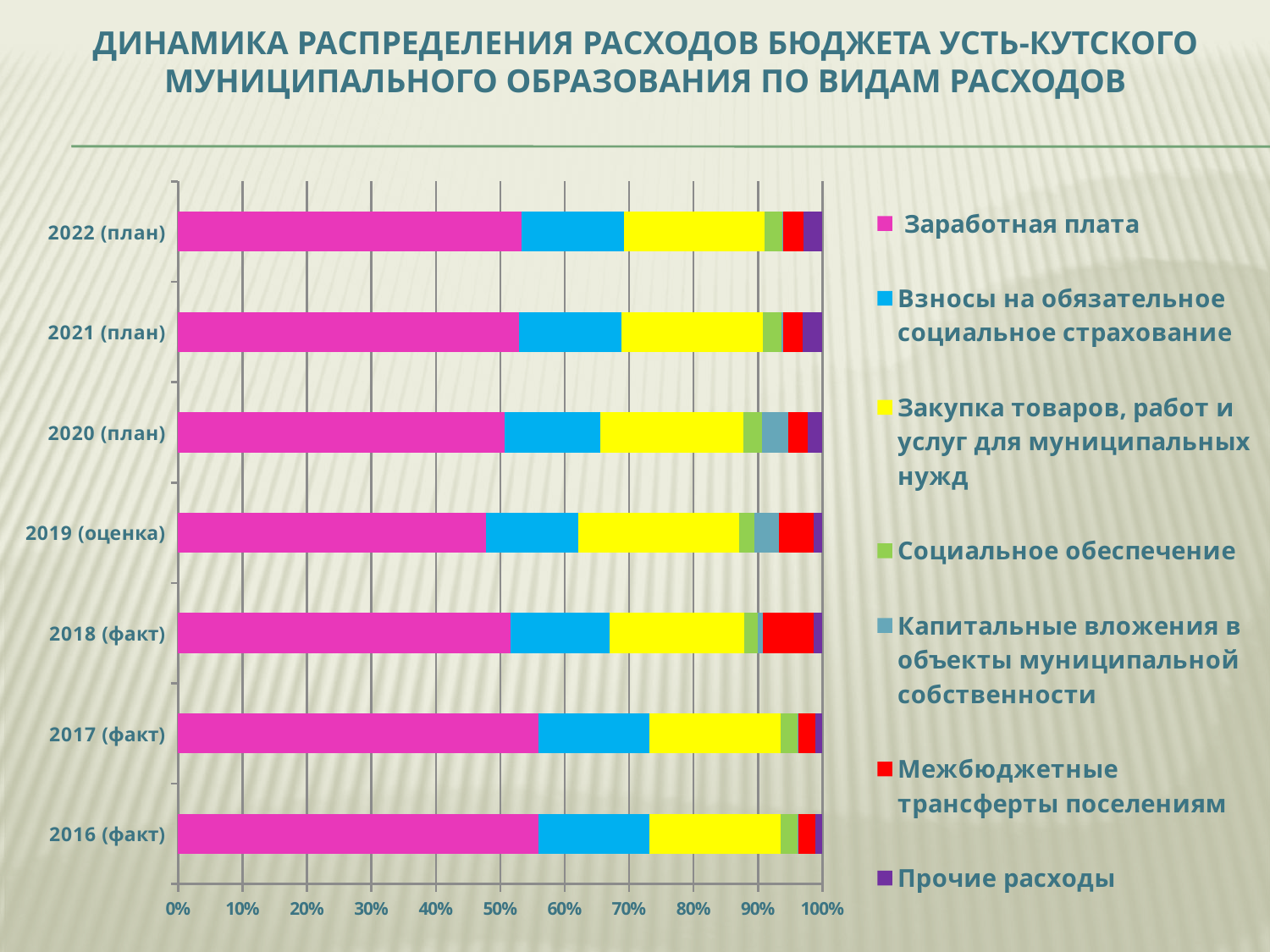
Does the share of Заработная плата rise or fall from 2017 (факт) to 2019 (оценка)? fall Which year has the lowest share of Заработная плата? 2019 (оценка) What kind of chart is shown on the slide? Stacked bar chart Is the share of Заработная плата for 2019 (оценка) greater or less than 50%? less What is the total of the stacked bar for 2016 (факт)? 100% Which colour represents Заработная плата in the chart legend? Magenta (pink) Which year has the largest share of Межбюджетные трансферты поселениям? 2018 (факт) How many year categories are shown on the vertical axis of the chart? 7 Is the share of Заработная плата for 2017 (факт) greater or less than 50%? greater Which series is shown in yellow in the chart? Закупка товаров, работ и услуг для муниципальных нужд Which is larger: the share of Заработная плата in 2017 (факт) or in 2019 (оценка)? 2017 (факт) How many series does the chart legend list? 7